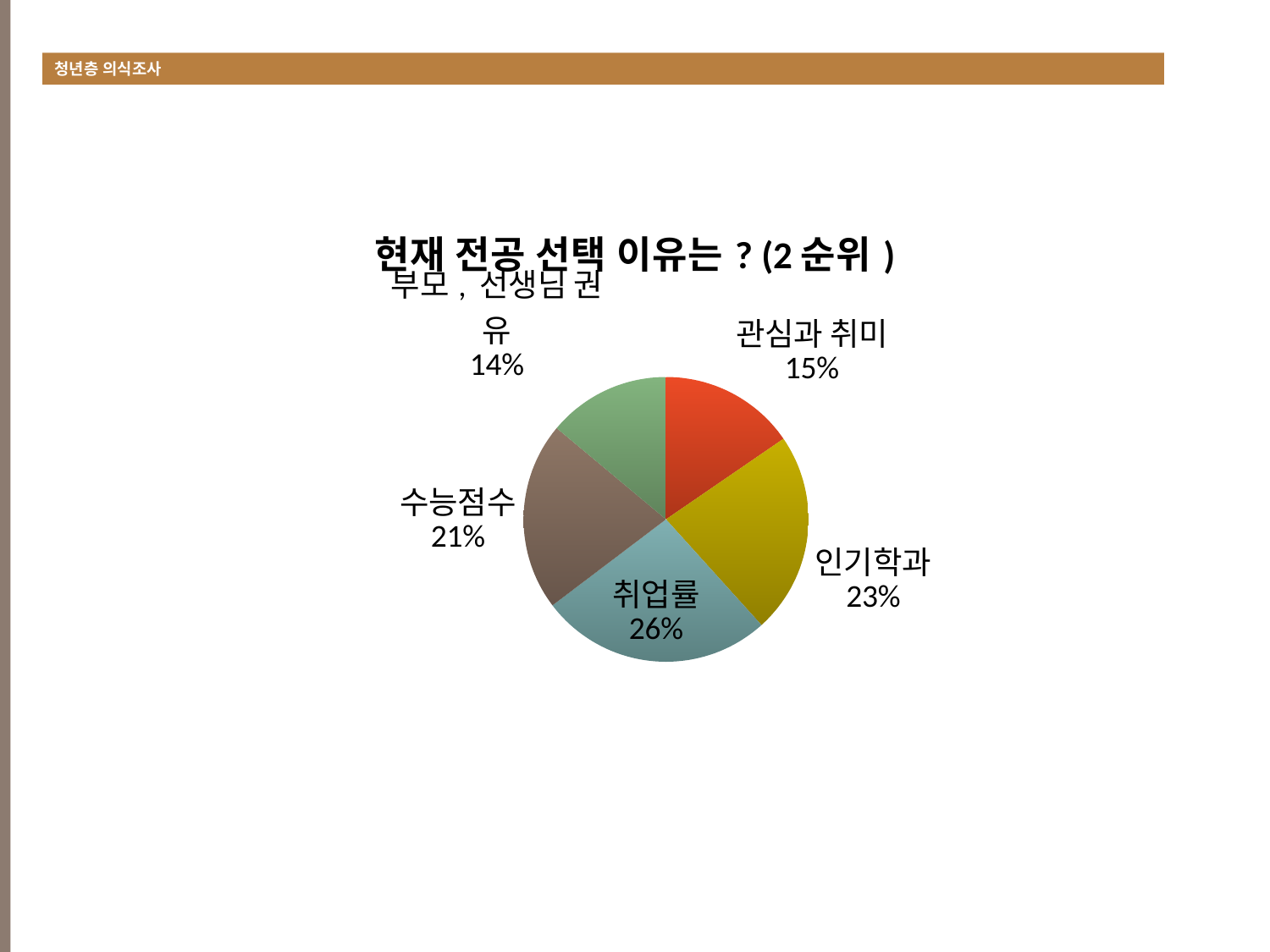
What percentage of the pie is labelled 취업률? 26% What percentage of the pie is labelled 부모, 선생님 권유? 14% What percentage of the pie is labelled 관심과 취미? 15% What is the difference in percentage points between 취업률 and 수능점수? 5 Which slice of the pie is the largest? 취업률 Which slice of the pie is the smallest? 부모, 선생님 권유 What kind of chart is shown on the slide? pie chart How many slices does the pie chart have? 5 What is the title of the chart? 현재 전공 선택 이유는 ? (2 순위 ) What percentage of the pie is labelled 수능점수? 21% What percentage of the pie is labelled 인기학과? 23% Which is larger, 인기학과 or 관심과 취미? 인기학과